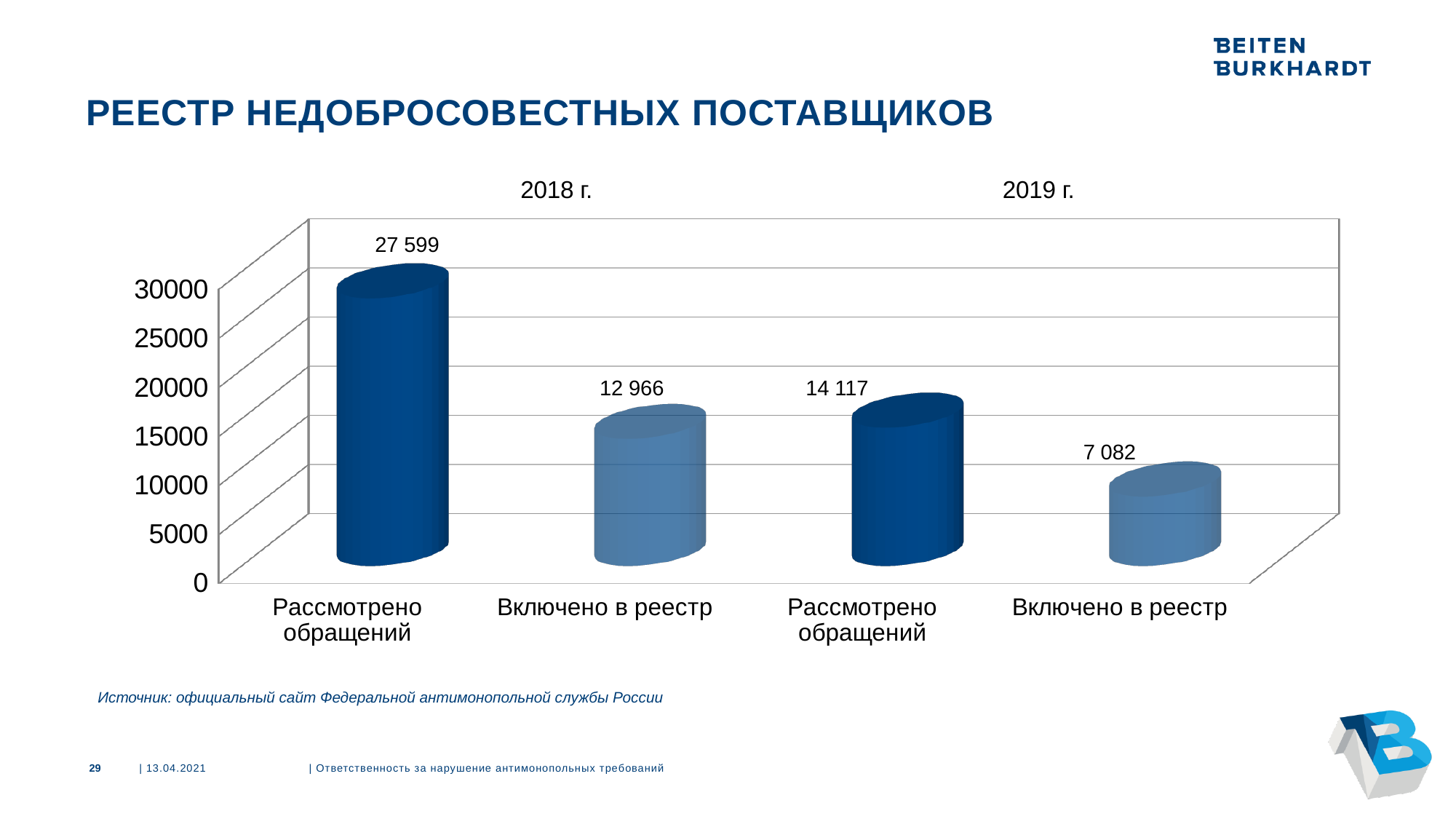
What is the difference between "Рассмотрено обращений" in 2018 г. and "Рассмотрено обращений" in 2019 г.? 13 482 What is the value for "Рассмотрено обращений" in 2019 г.? 14 117 What is the value for "Включено в реестр" in 2019 г.? 7 082 Which bar has the highest value on the chart? Рассмотрено обращений, 2018 г. What is the value for "Рассмотрено обращений" in 2018 г.? 27 599 Which is larger: "Включено в реестр" in 2018 г. or "Рассмотрено обращений" in 2019 г.? Рассмотрено обращений in 2019 г. Which bar has the lowest value on the chart? Включено в реестр, 2019 г. What kind of chart is shown on the slide? Bar chart What is the title of the slide containing the chart? РЕЕСТР НЕДОБРОСОВЕСТНЫХ ПОСТАВЩИКОВ How many bars are plotted on the chart? 4 What is the value for "Включено в реестр" in 2018 г.? 12 966 What is the difference between "Рассмотрено обращений" and "Включено в реестр" in 2018 г.? 14 633